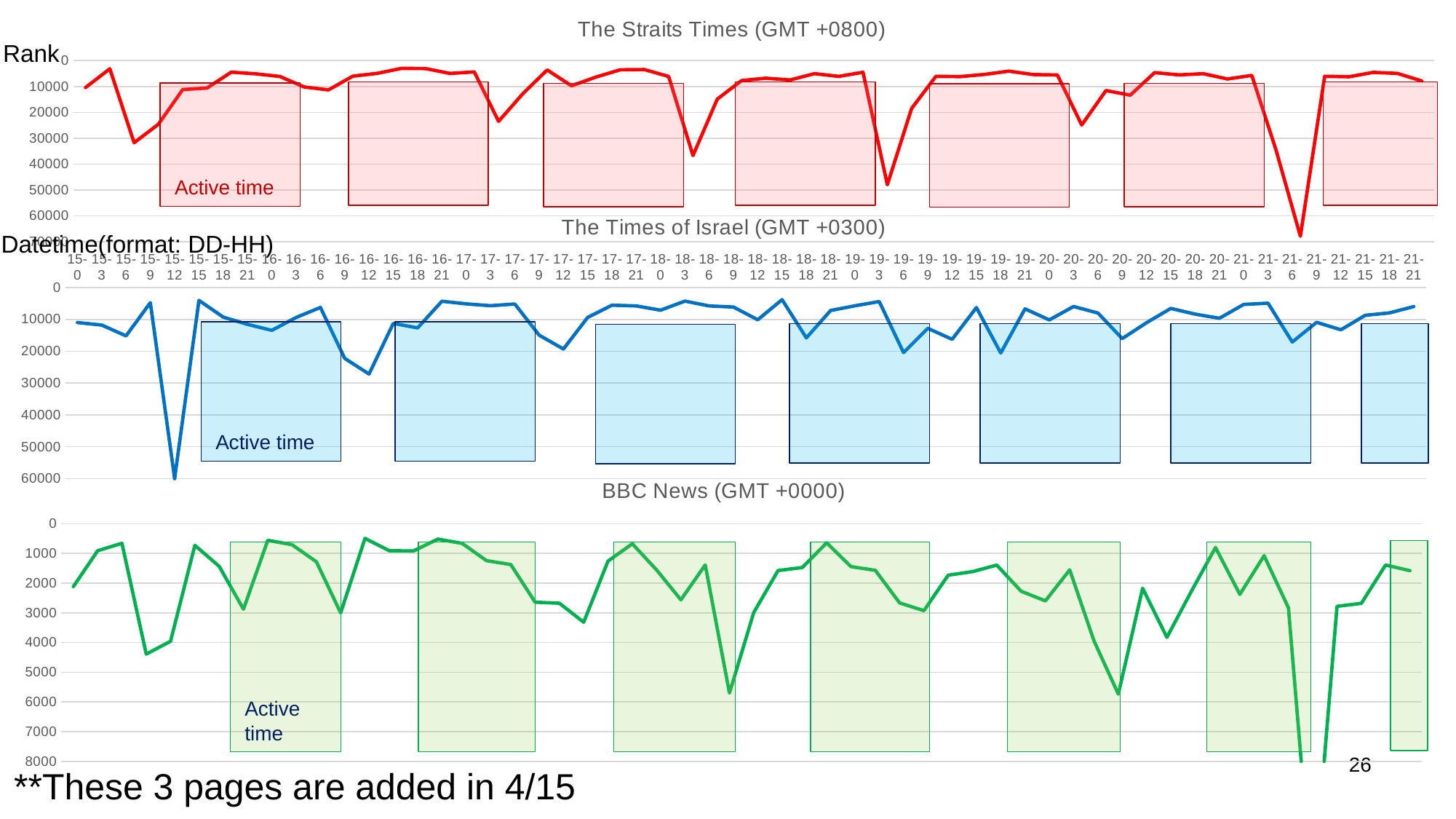
How many shaded 'Active time' boxes are drawn on the BBC News (GMT +0000) chart? 7 In The Straits Times (GMT +0800) chart, is the value at 15-0 greater or less than 20000? less In the BBC News (GMT +0000) chart, is the value at the deepest dip near 21-6 greater or less than 7000? greater In The Times of Israel (GMT +0300) chart, is the value at the deepest dip near 15-12 greater or less than 50000? greater How many shaded 'Active time' boxes are drawn on The Times of Israel (GMT +0300) chart? 7 What colour is the line in The Times of Israel (GMT +0300) chart? blue What kind of chart is used for The Straits Times (GMT +0800)? line chart How many charts are shown on the slide? 3 In the BBC News (GMT +0000) chart, what is the largest value shown on the vertical axis? 8000